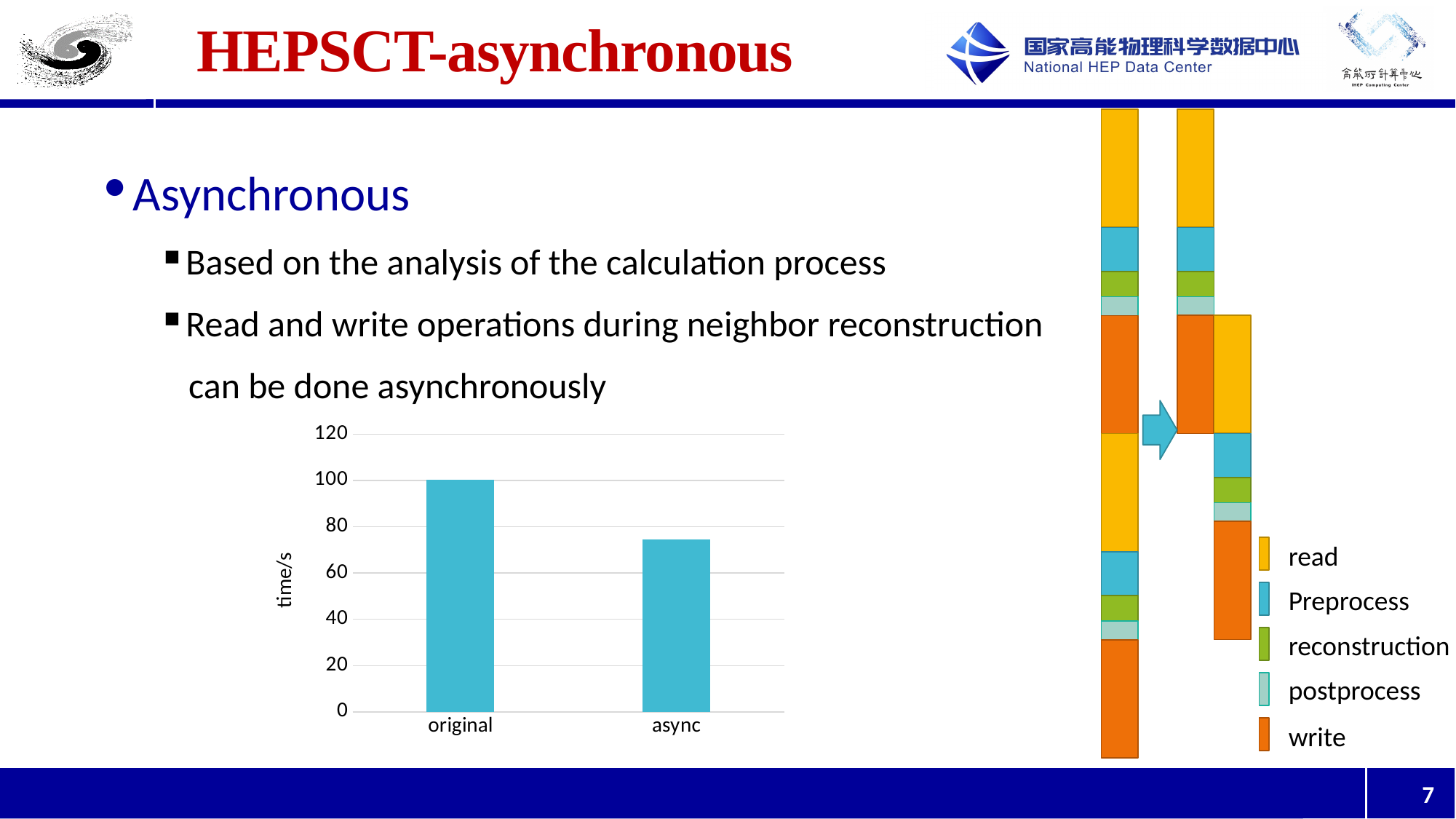
What kind of chart is shown on the slide? bar chart What is the highest tick value shown on the vertical axis of the bar chart? 120 What is the label on the vertical axis of the bar chart? time/s Is the value for async greater or less than 80? less What are the two category labels on the x axis of the bar chart? original and async Is the value for async greater or less than 60? greater Which is larger, the value for original or the value for async? original Do the values fall or rise from original to async along the x axis? fall Which category has the lowest value in the bar chart? async Which category has the highest value in the bar chart? original How many categories are plotted on the bar chart? 2